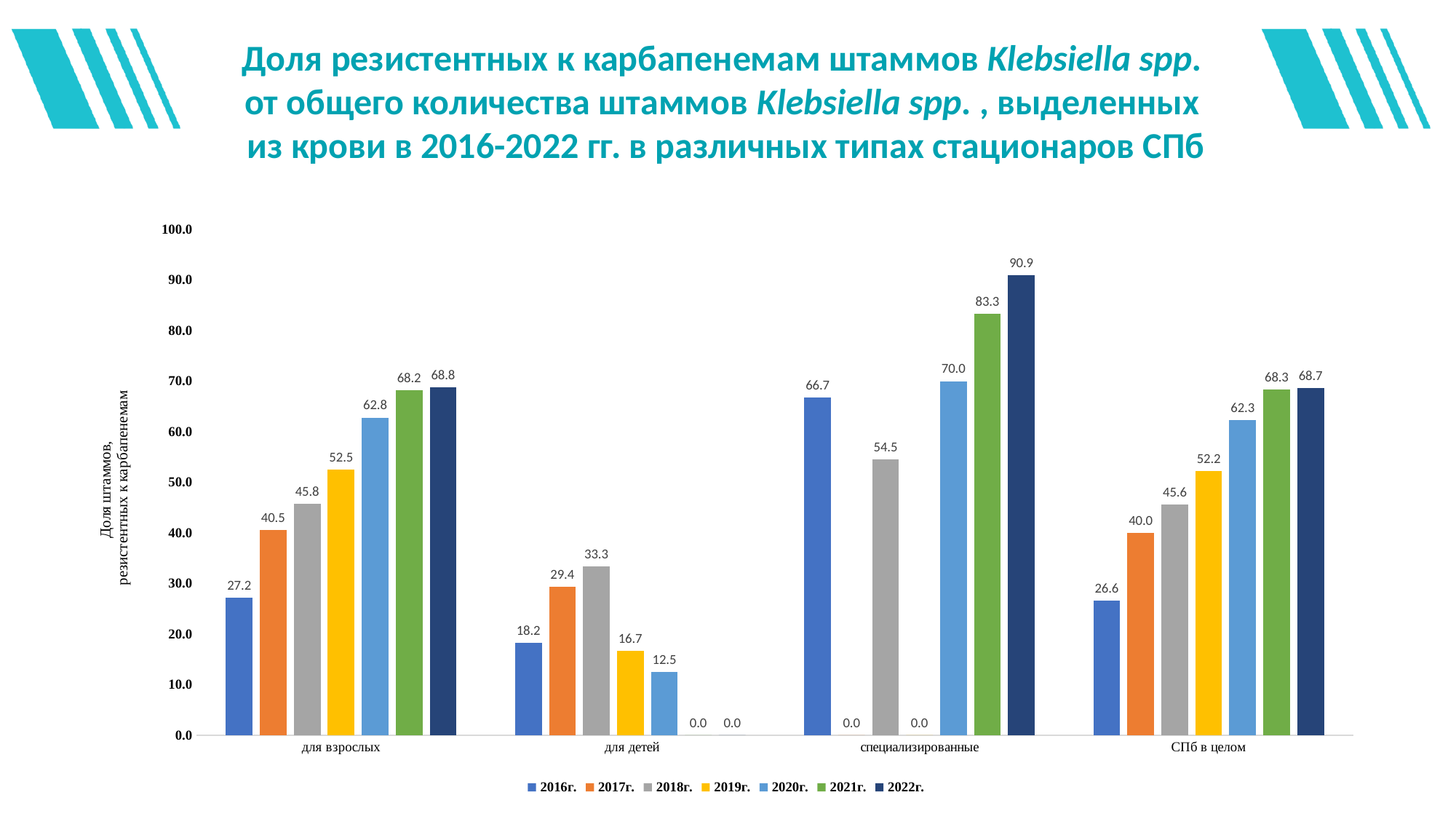
What is the value for 2019г. in the category 'СПб в целом'? 52.2 What type of chart is shown on the slide? bar chart What is the value for 2022г. in the category 'специализированные'? 90.9 Which is larger: the 2020г. value for 'для взрослых' or the 2020г. value for 'специализированные'? специализированные What is the value for 2016г. in the category 'для взрослых'? 27.2 Which year has the highest value in the category 'для детей'? 2018г. What is the value for 2020г. in the category 'для детей'? 12.5 Do the values for 'СПб в целом' rise or fall from 2016г. to 2022г.? rise How many series does the legend list? 7 What is the difference between the 2022г. and 2016г. values in the category 'СПб в целом'? 42.1 How many categories are shown on the x axis? 4 Which category has the lowest value for 2021г.? для детей